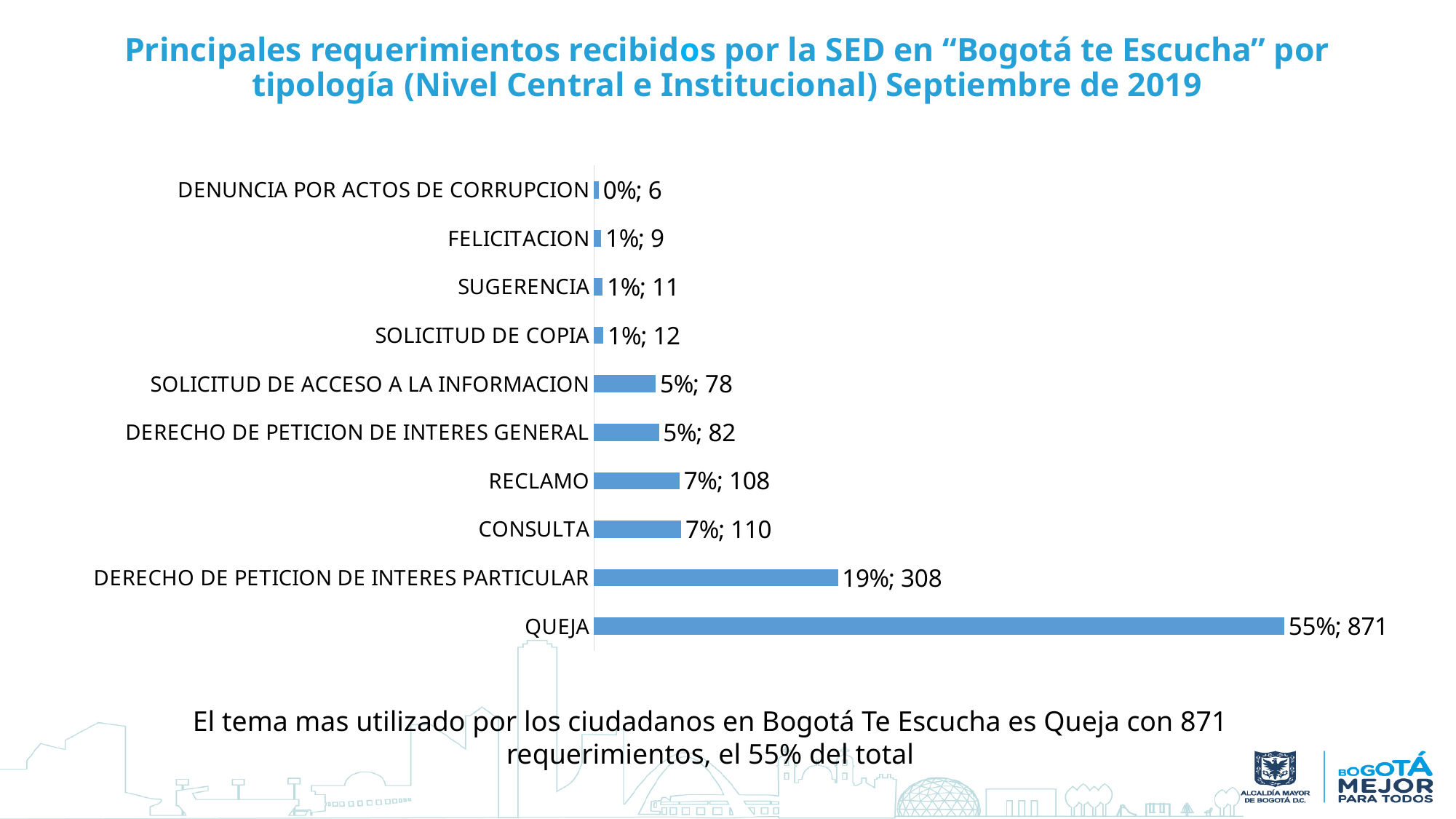
What type of chart is shown on the slide? Bar chart What is the number of requests for QUEJA? 871 What is the number of requests for CONSULTA? 110 What percentage is shown for DERECHO DE PETICION DE INTERES PARTICULAR? 19% Which category has the highest number of requests? QUEJA What is the difference in number of requests between CONSULTA and RECLAMO? 2 Which category has the lowest number of requests? DENUNCIA POR ACTOS DE CORRUPCION Which has more requests, DERECHO DE PETICION DE INTERES GENERAL or SOLICITUD DE ACCESO A LA INFORMACION? DERECHO DE PETICION DE INTERES GENERAL What is the difference in number of requests between QUEJA and DERECHO DE PETICION DE INTERES PARTICULAR? 563 How many categories are shown in the chart? 10 What is the number of requests for SOLICITUD DE ACCESO A LA INFORMACION? 78 What percentage of the total do QUEJA requests represent according to the slide? 55%